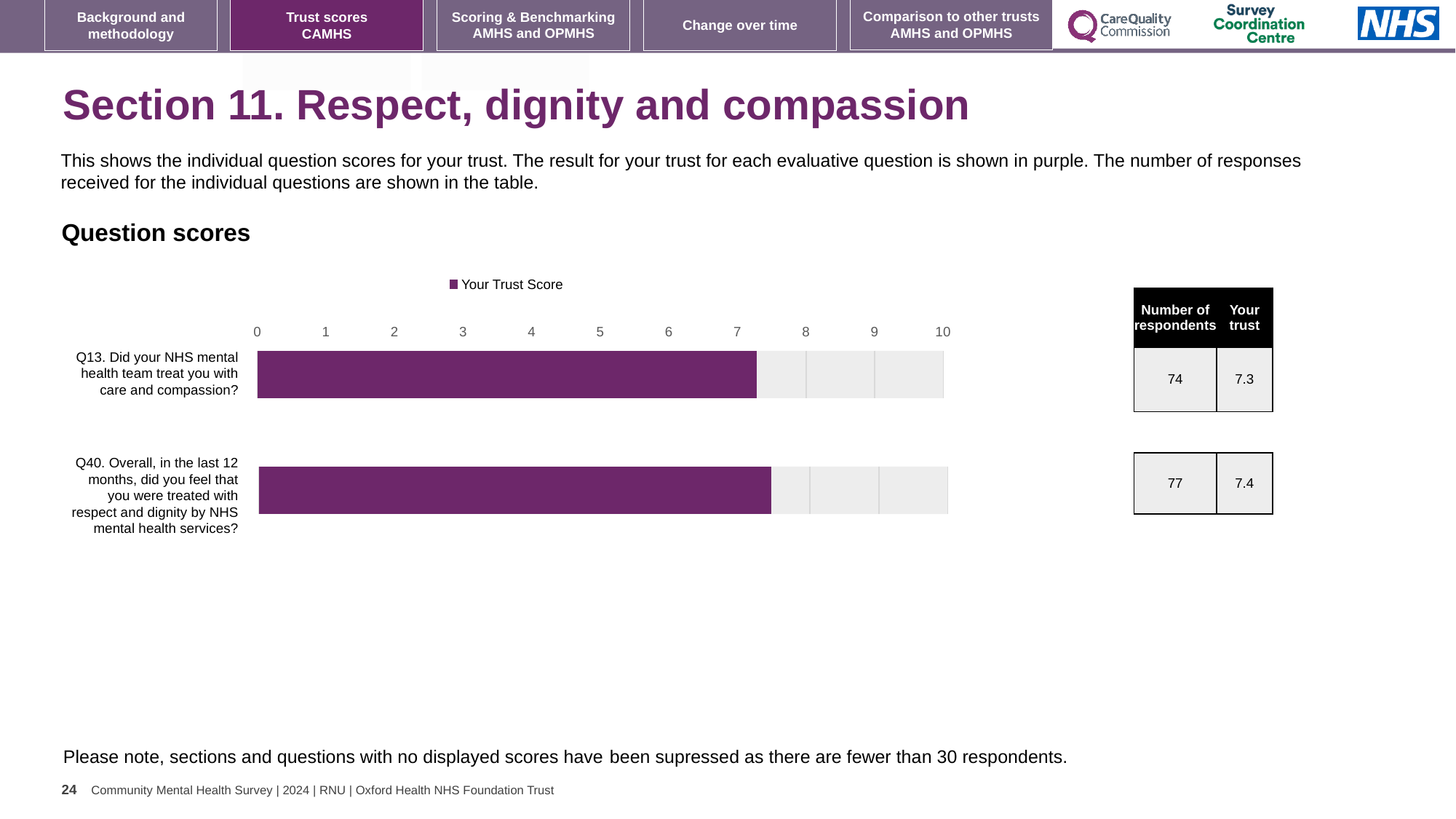
Is the Your Trust Score for Q13 greater or less than 7? greater How many respondents answered Q40 according to the table? 77 What type of chart is used to show the question scores? Bar chart What is the Your Trust Score for Q40 (Overall, in the last 12 months, did you feel that you were treated with respect and dignity by NHS mental health services?)? 7.4 Which question has the higher Your Trust Score, Q13 or Q40? Q40 What is the difference between the Your Trust Score for Q40 and Q13? 0.1 What is the name of the series shown in the chart legend? Your Trust Score How many respondents answered Q13 according to the table? 74 How many series does the chart legend list? 1 What is the Your Trust Score for Q13 (Did your NHS mental health team treat you with care and compassion?)? 7.3 How many questions are plotted in the Question scores chart? 2 Is the Your Trust Score for Q40 greater or less than 8? less